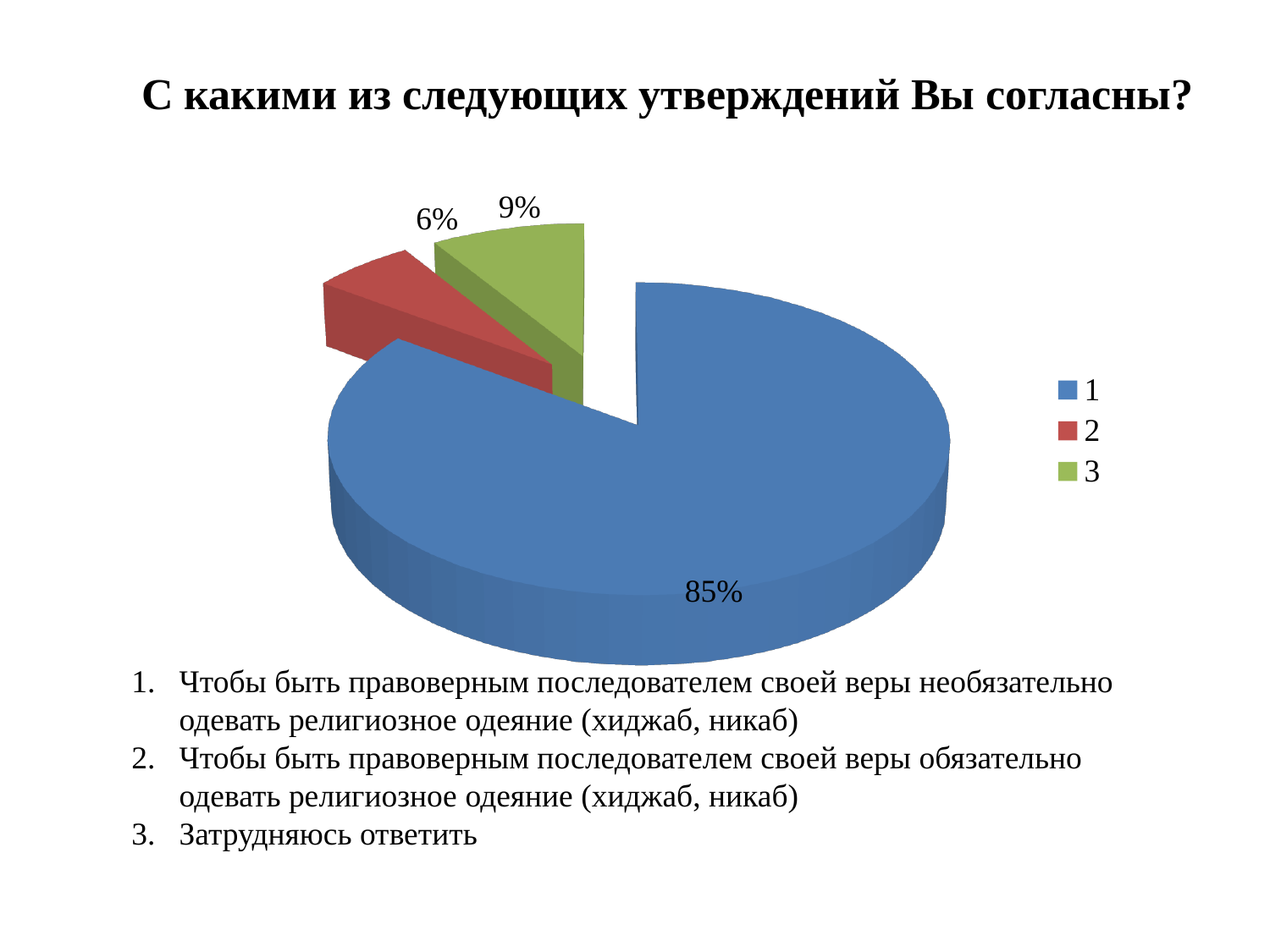
What kind of chart is shown on the slide? Pie chart What percentage is shown for category 3 in the pie chart? 9% What percentage is shown for category 2 in the pie chart? 6% Which category has the largest slice of the pie chart? 1 What is the difference in percentage points between category 1 and category 3? 76 Which category has the smallest slice of the pie chart? 2 What percentage is shown for category 1 in the pie chart? 85% What is the difference in percentage points between category 3 and category 2? 3 How many slices does the pie chart have? 3 Which is larger, the slice for category 2 or the slice for category 3? 3 How many entries does the legend list? 3 What colour is the slice for category 1 in the pie chart? Blue